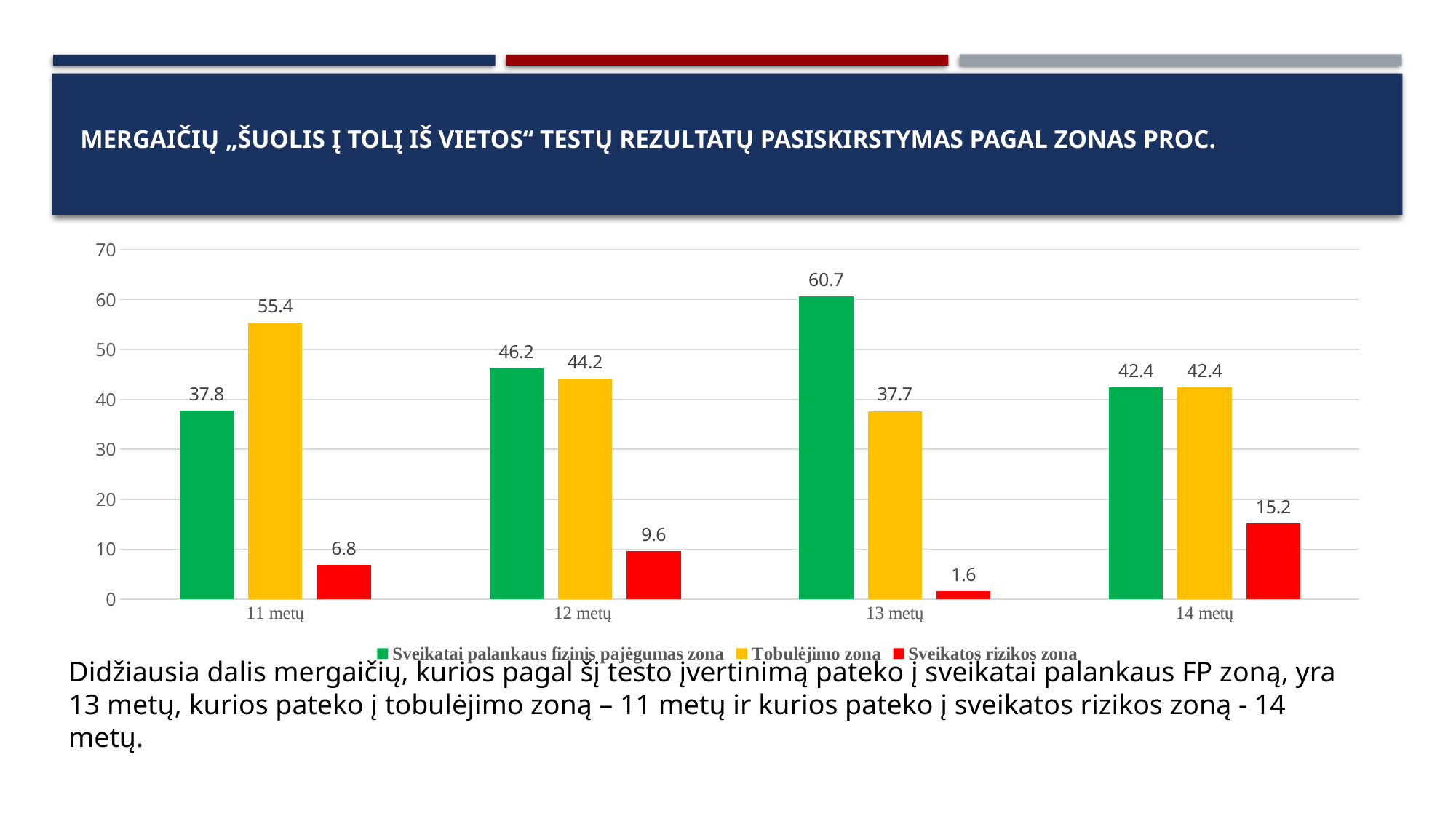
Which age group has the highest value for "Sveikatai palankaus fizinis pajėgumas zona"? 13 metų What colour represents "Sveikatos rizikos zona" in the chart? red Is the value for "Sveikatos rizikos zona" at 14 metų greater or less than 20? less Which is larger at 12 metų: "Sveikatai palankaus fizinis pajėgumas zona" or "Tobulėjimo zona"? Sveikatai palankaus fizinis pajėgumas zona What is the value for "Sveikatai palankaus fizinis pajėgumas zona" at 12 metų? 46.2 What is the difference between the "Tobulėjimo zona" values at 11 metų and 13 metų? 17.7 How many series does the legend list? 3 What kind of chart is shown on the slide? bar chart What is the value for "Sveikatos rizikos zona" at 13 metų? 1.6 What is the value for "Tobulėjimo zona" at 11 metų? 55.4 How many age groups are shown on the x axis? 4 Which age group has the lowest value for "Sveikatos rizikos zona"? 13 metų